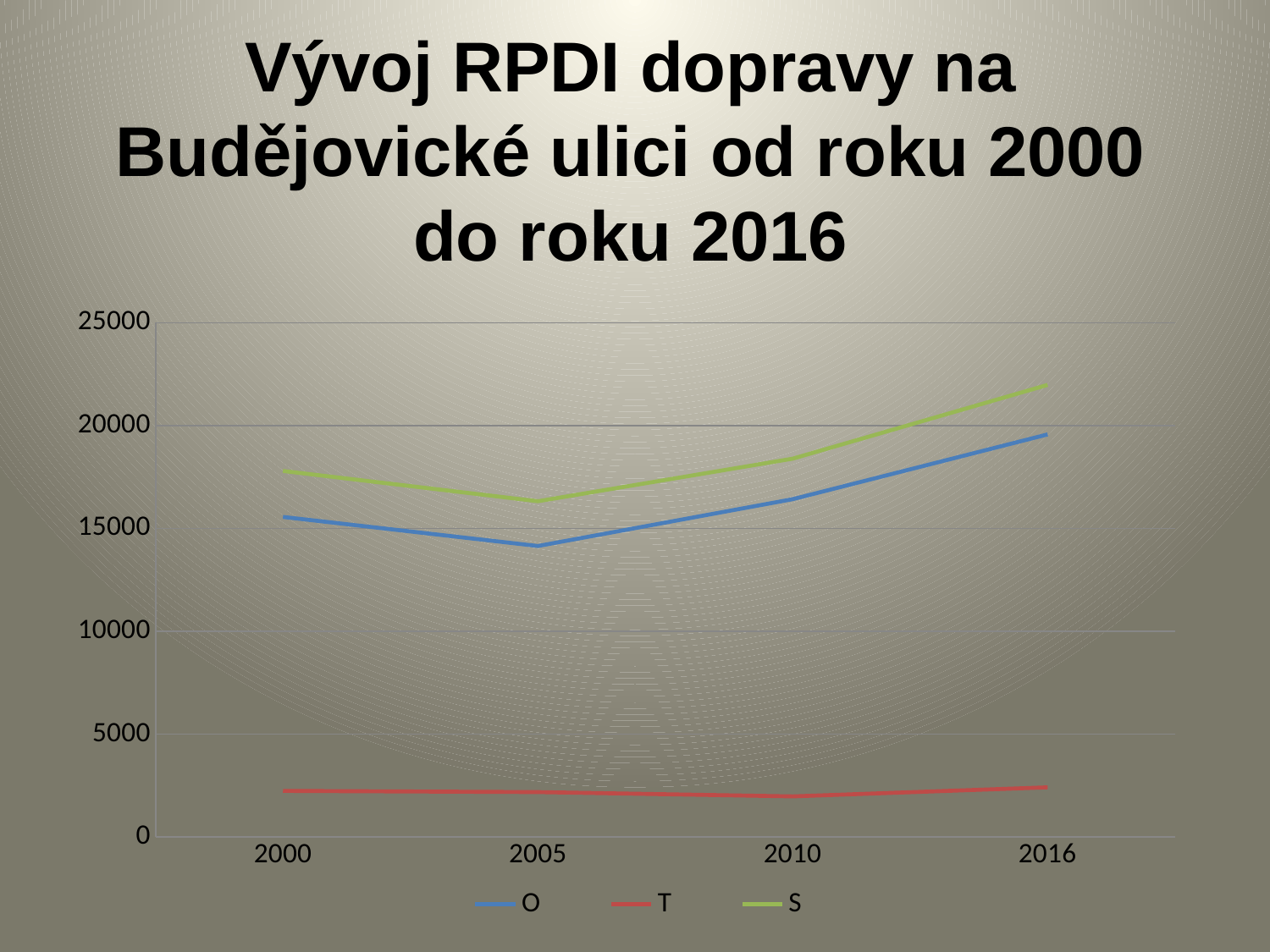
How many years are plotted along the x axis? 4 Which series has the highest values throughout the chart? S Is the value for series T in 2010 greater or less than 5000? less Which is larger: the value for series O in 2000 or in 2016? 2016 Which series has the lowest values throughout the chart? T In which year does series S reach its highest value? 2016 What kind of chart is shown on the slide? line chart Is the value for series O in 2005 greater or less than 15000? less What is the title of the chart? Vývoj RPDI dopravy na Budějovické ulici od roku 2000 do roku 2016 Is the value for series S in 2016 greater or less than 20000? greater In which year does series O reach its lowest value? 2005 How many series does the legend list? 3